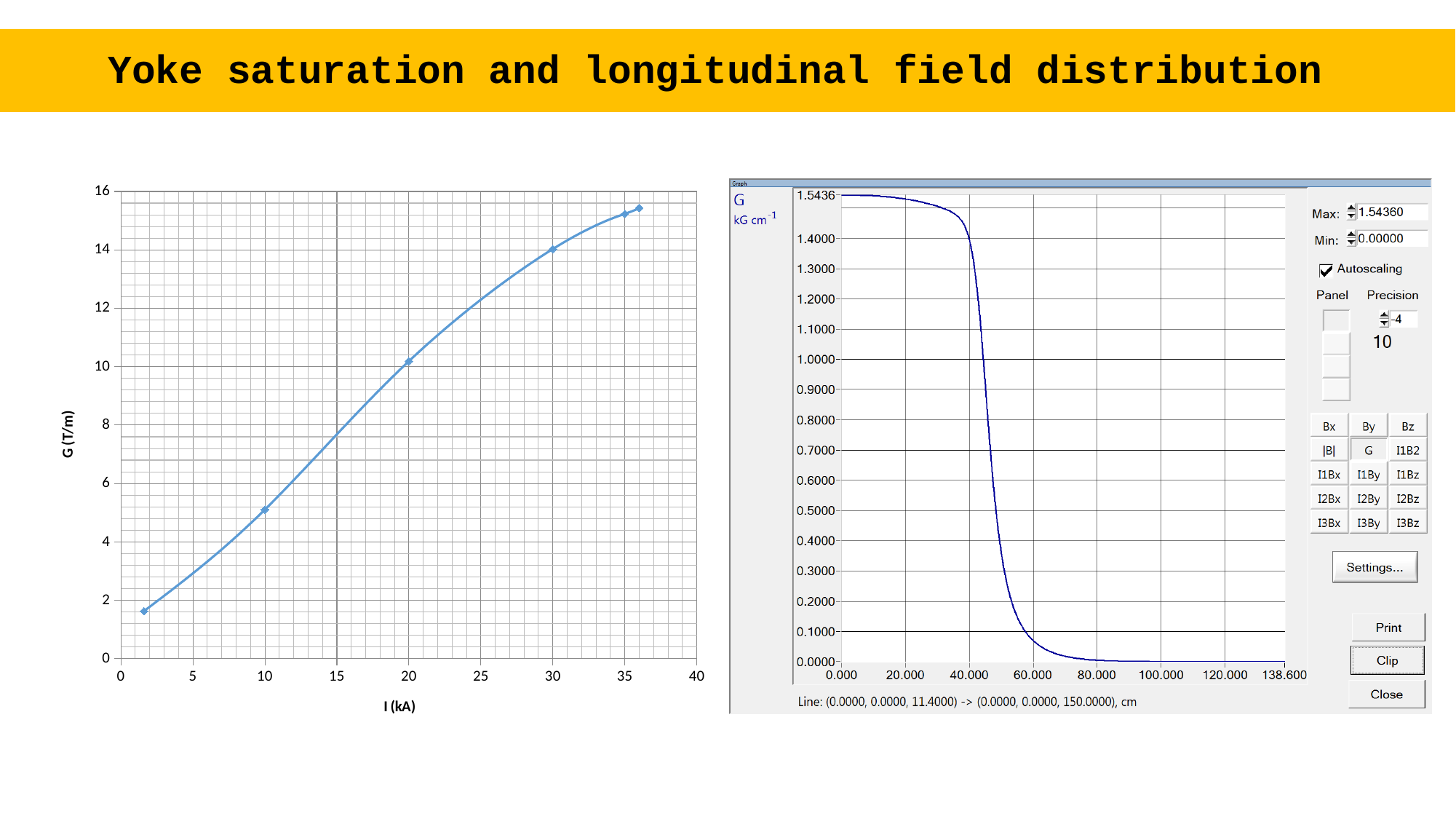
In the left chart, what is the label of the y axis? G (T/m) What kind of chart is the left chart (G vs I)? line chart In the left chart, is the value of G at I = 35 kA greater or less than 16 T/m? less In the left chart, how many data points are marked on the line? 6 In the right chart, is the value at x = 60.000 greater or less than 0.5000? less In the right chart, what is the highest value shown on the y axis? 1.5436 In the left chart, is the value of G at I = 10 kA greater or less than 4 T/m? greater In the right chart, does the curve rise or fall as the position along the x axis increases? falls In the left chart, what is the label of the x axis? I (kA) In the left chart, does G rise or fall as I increases? rises